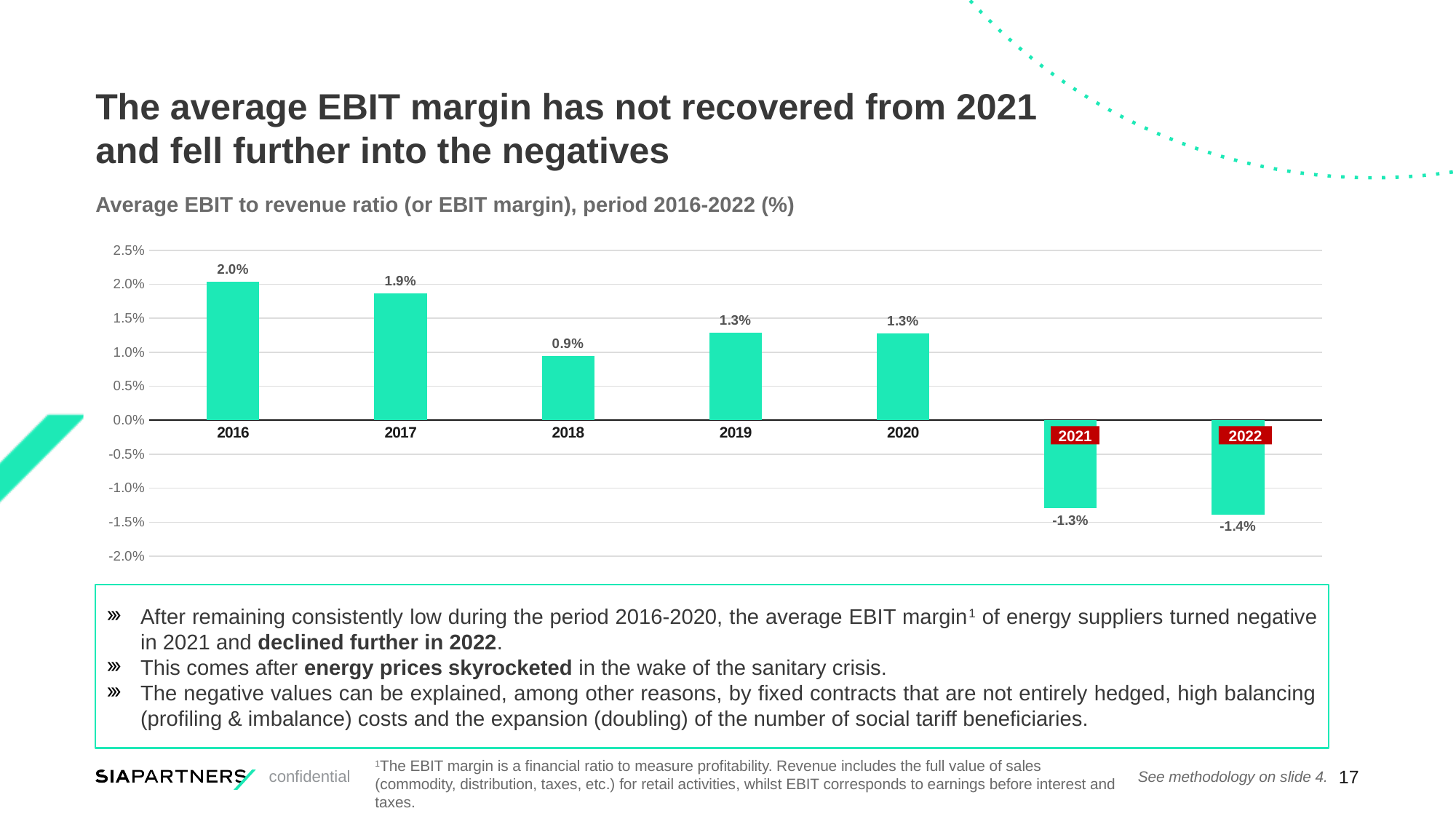
What is the average EBIT margin for 2016? 2.0% Is the value for 2021 greater or less than 0.0%? less What is the average EBIT margin for 2022? -1.4% What is the average EBIT margin for 2018? 0.9% What is the difference between the EBIT margin in 2016 and in 2018? 1.1% Which year has the lowest average EBIT margin? 2022 What is the title of the chart? Average EBIT to revenue ratio (or EBIT margin), period 2016-2022 (%) Which year has a higher EBIT margin, 2017 or 2019? 2017 How many years are shown on the chart? 7 Which year has the highest average EBIT margin? 2016 What kind of chart is shown on the slide? Bar chart Does the average EBIT margin rise or fall from 2020 to 2022? Fall